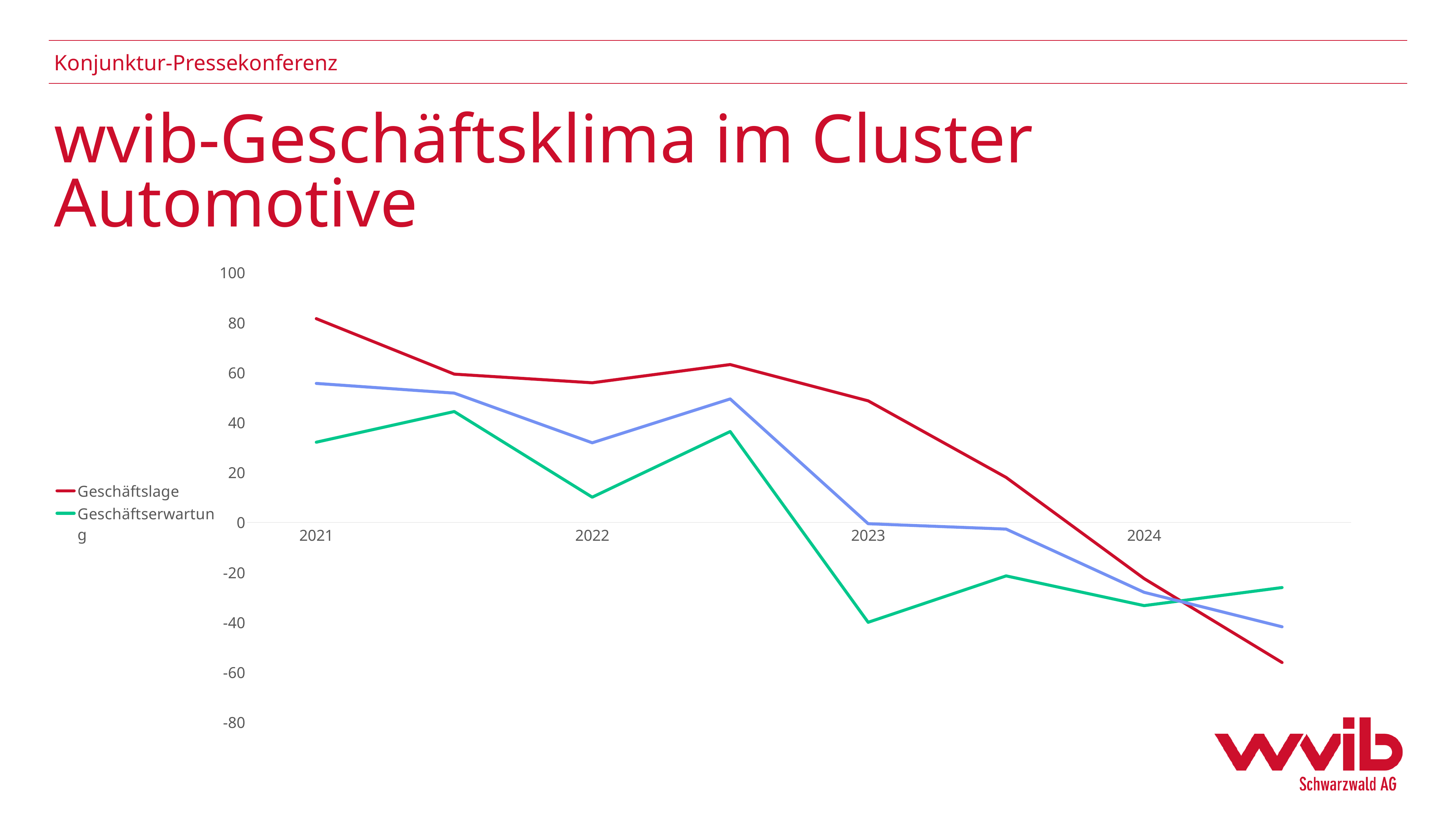
Is the value for Geschäftslage in 2024 greater or less than 0? less Is the value for Geschäftslage in 2022 greater or less than 40? greater In 2023, which is higher: Geschäftslage or Geschäftserwartung? Geschäftslage Which colour is used for the Geschäftslage line? red Is the value for Geschäftserwartung in 2021 greater or less than 20? greater How many series does the legend list? 2 In which labelled year is the Geschäftslage line at its highest? 2021 What is the title of the slide's chart? wvib-Geschäftsklima im Cluster Automotive What kind of chart is shown on the slide? line chart Does the Geschäftslage line rise or fall overall from 2021 to 2024? fall